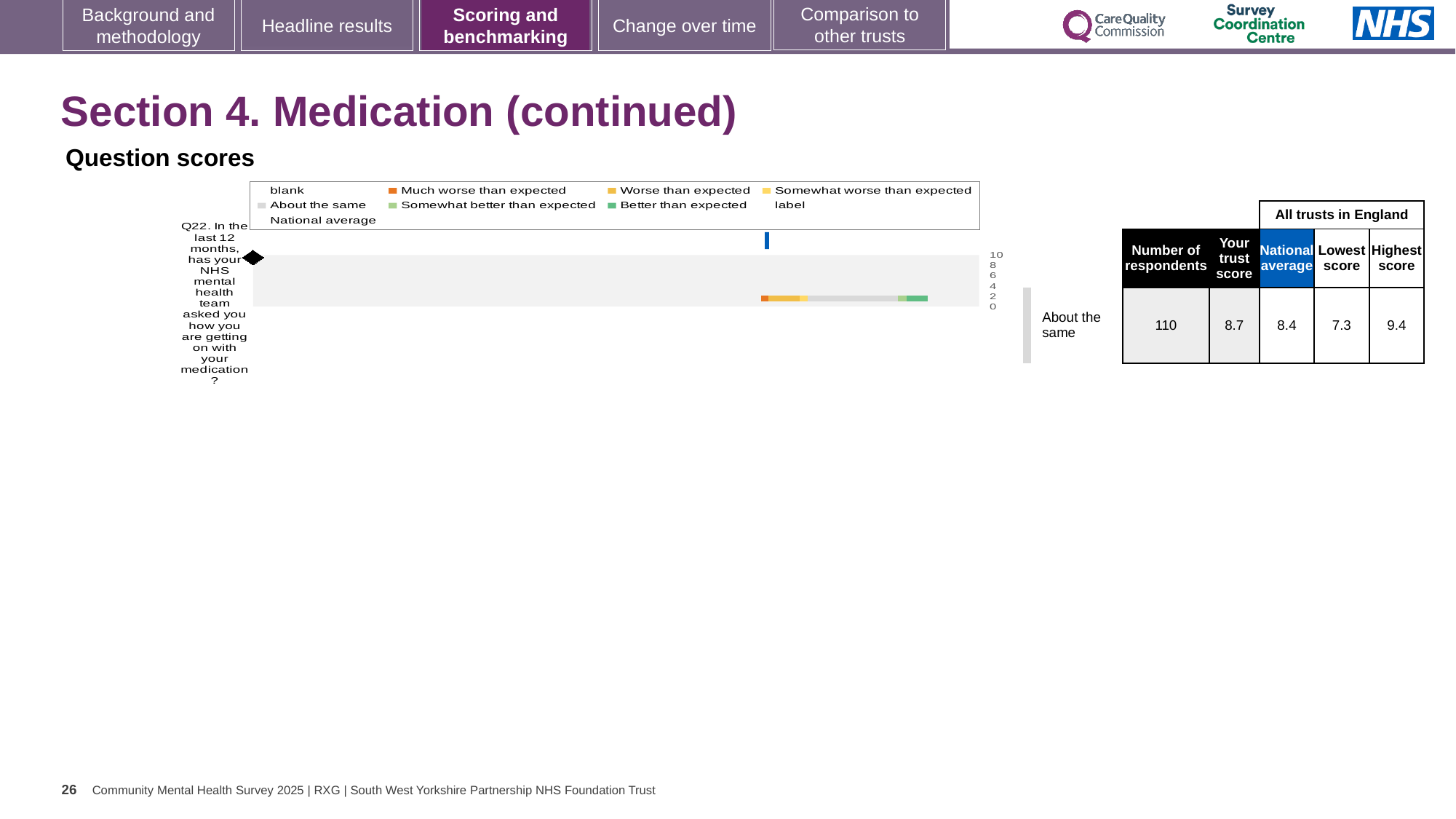
What kind of chart is used to show the Q22 question score? bar chart How many questions are plotted in the question scores chart? 1 What is the national average score for Q22 shown in the table beside the chart? 8.4 For Q22, which is larger: the trust's score or the national average? the trust's score How many respondents answered Q22 according to the table beside the chart? 110 What is the highest tick value shown on the chart's score axis? 10 What is the lowest score among all trusts in England for Q22? 7.3 What is the trust's score for Q22 shown in the table beside the chart? 8.7 What is the difference between the highest and lowest scores among all trusts in England for Q22? 2.1 What is the highest score among all trusts in England for Q22? 9.4 Which benchmark category is the trust's Q22 score placed in, as labelled next to the chart? About the same How many entries does the legend of the question scores chart list? 9